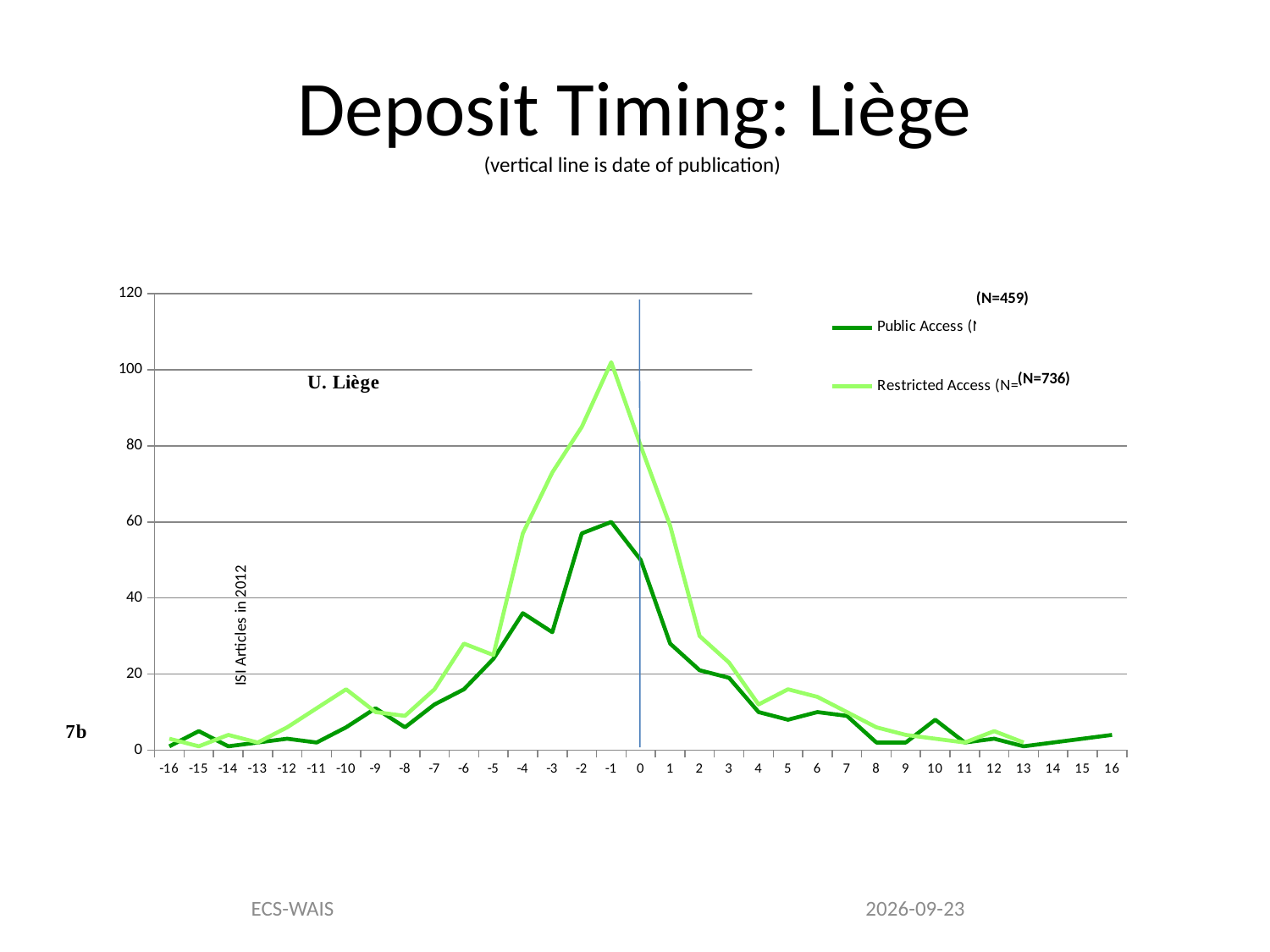
Is the Restricted Access value at x = 2 greater or less than 40? less According to the subtitle, what does the vertical line in the chart represent? date of publication How many x-axis points (months) are plotted, from -16 to 16? 33 At which x-axis value does the Public Access line reach its highest point? -1 What N value is shown for the Restricted Access series in the legend? N=736 At which x-axis value does the Restricted Access line reach its highest point? -1 Does the Restricted Access line rise or fall as x goes from -1 to 16? fall At x = -1, which series has the larger value, Public Access or Restricted Access? Restricted Access Is the Restricted Access value at x = -1 greater or less than 80? greater How many series does the legend list? 2 What kind of chart is shown on the slide? line chart Is the Public Access value at x = 0 greater or less than 40? greater